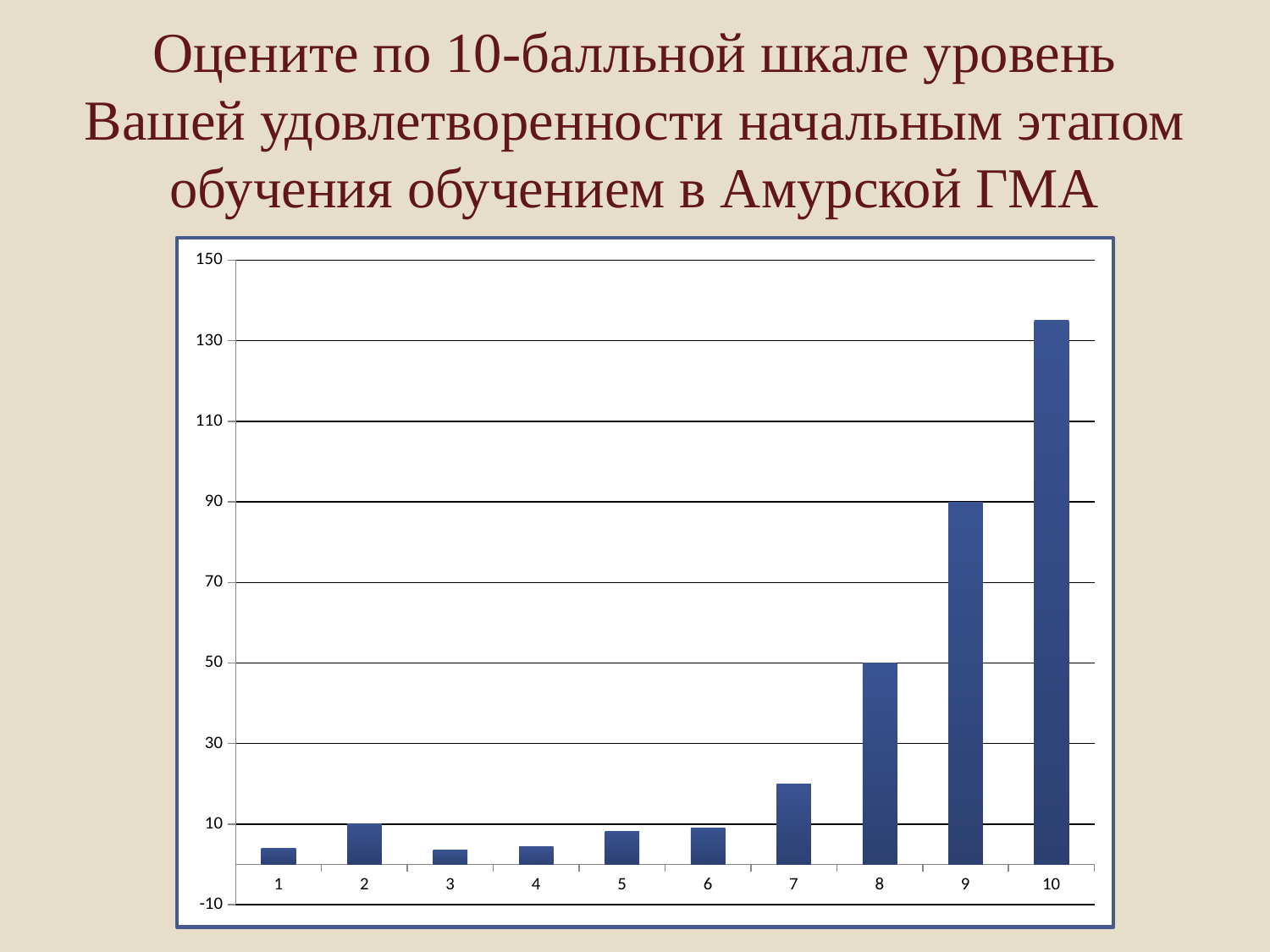
What is the value for category 8? 50 Which category has the highest bar? 10 Is the value for category 10 greater or less than 130? greater Is the value for category 7 greater or less than 30? less What is the value for category 9? 90 Do the values generally rise or fall from category 6 to category 10? rise Which has a larger value, category 9 or category 8? 9 Is the value for category 1 greater or less than 10? less What is the difference between the values for category 9 and category 8? 40 Which has a larger value, category 7 or category 6? 7 What kind of chart is shown on the slide? bar chart How many categories are shown on the x axis of the chart? 10